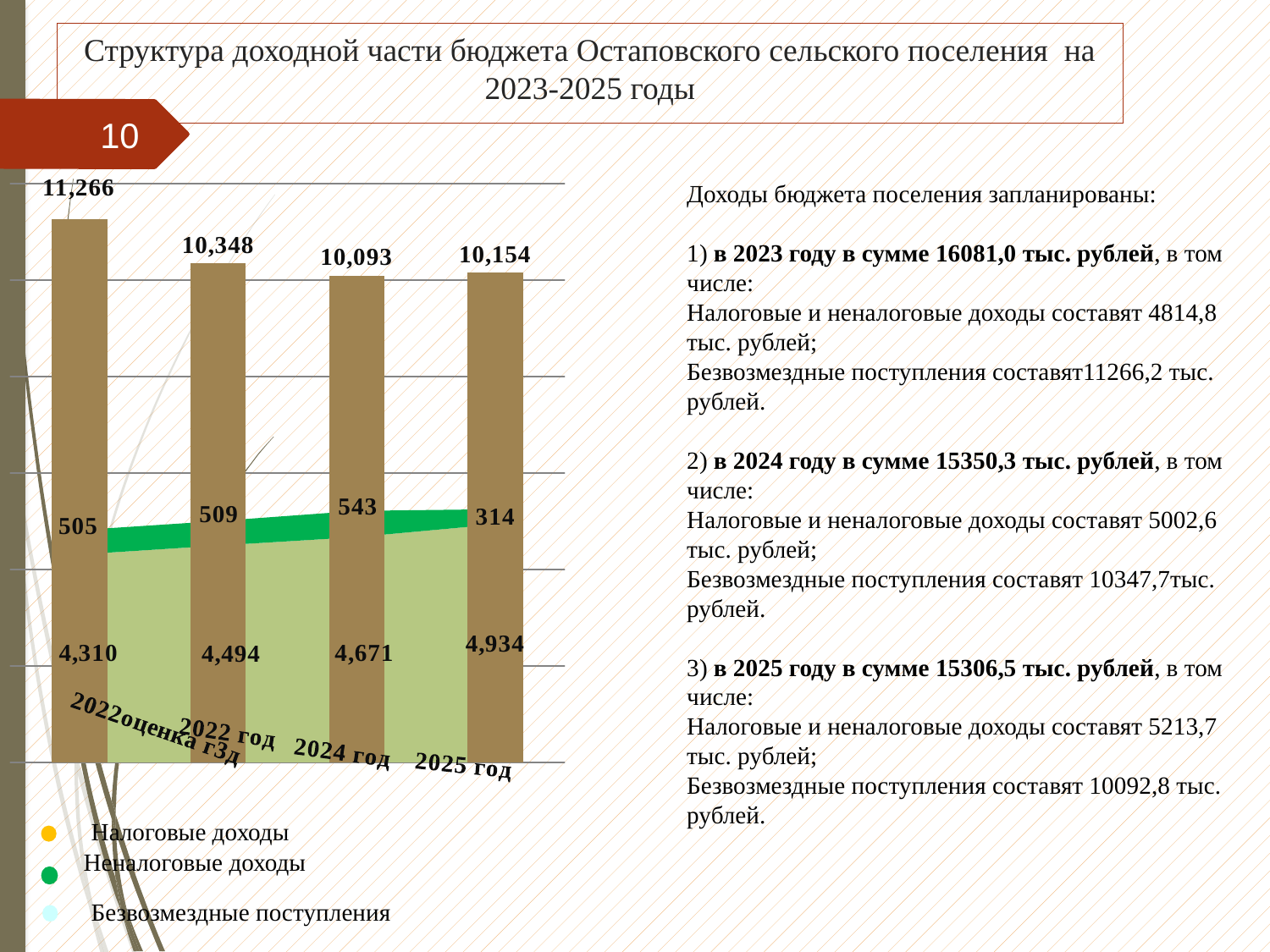
How many categories are shown on the x axis of the chart? 4 Which is larger, Безвозмездные поступления for 2024 год or for 2025 год? 2025 год Which category has the lowest value of Неналоговые доходы? 2025 год How many series does the chart legend list? 3 What is the value of Безвозмездные поступления for 2022оценка? 11,266 What is the difference between Налоговые доходы for 2025 год and 2024 год? 263 Which category has the highest value of Безвозмездные поступления? 2022оценка What is the value of Налоговые доходы for 2024 год? 4,671 What is the difference between Безвозмездные поступления for 2022оценка and 2025 год? 1,112 What is the value of Неналоговые доходы for 2025 год? 314 Do the values of Налоговые доходы rise or fall from left to right along the x axis? rise What is the value of Безвозмездные поступления for 2025 год? 10,154